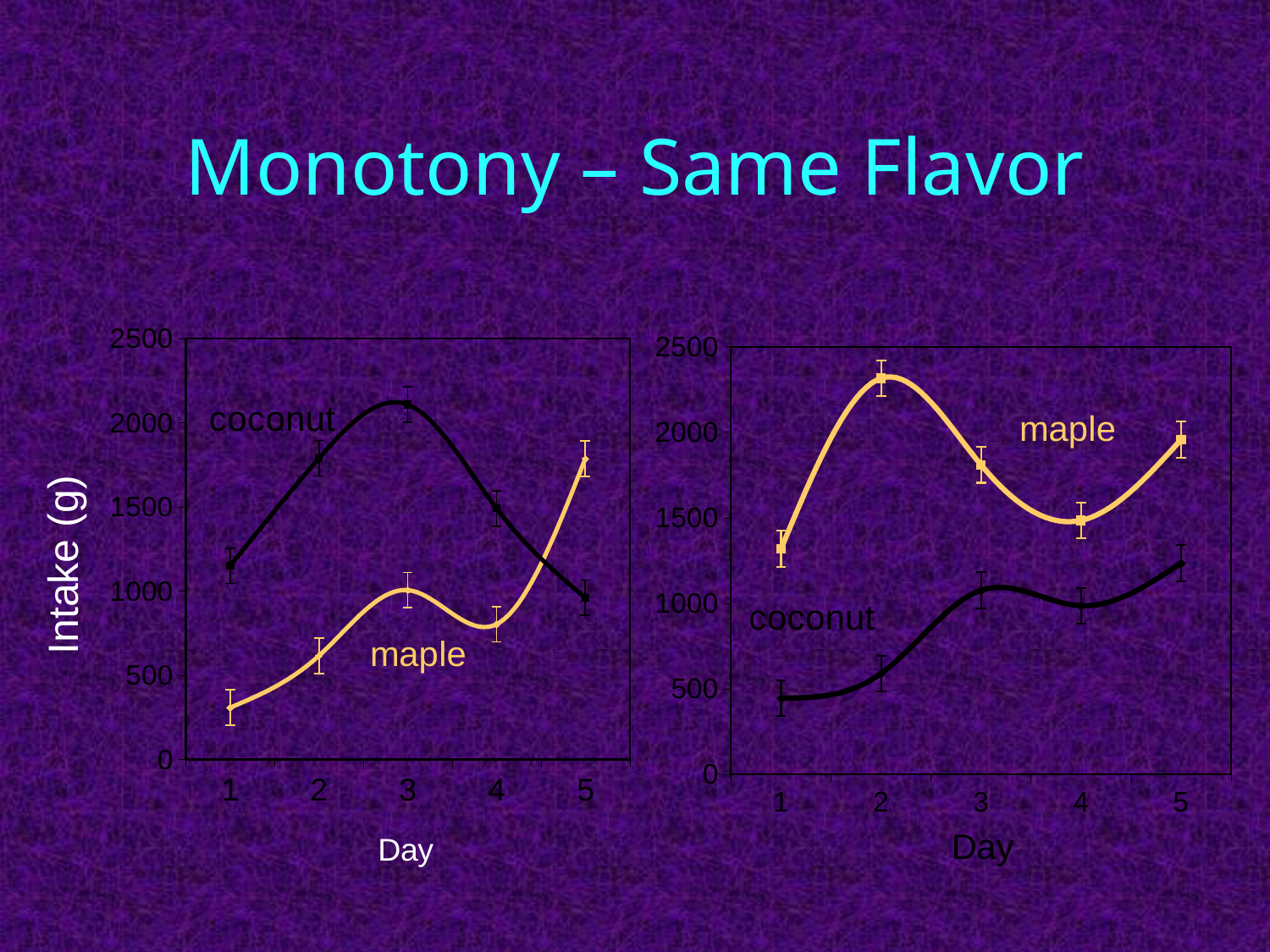
On the left chart, is the coconut value on day 3 greater or less than 2000? greater On the left chart, how many days are shown on the x axis? 5 What is the label on the y axis of the charts? Intake (g) On the right chart, is the coconut value on day 1 greater or less than 500? less On the left chart, which series has the larger value on day 5, coconut or maple? maple On the left chart, on which day is coconut intake highest? 3 On the left chart, on which day is maple intake lowest? 1 What kind of chart is the left chart? line chart On the left chart, is the maple value on day 1 greater or less than 500? less On the right chart, on which day is maple intake highest? 2 On the right chart, which series has the larger value on day 3, coconut or maple? maple On the left chart, how many series are plotted? 2